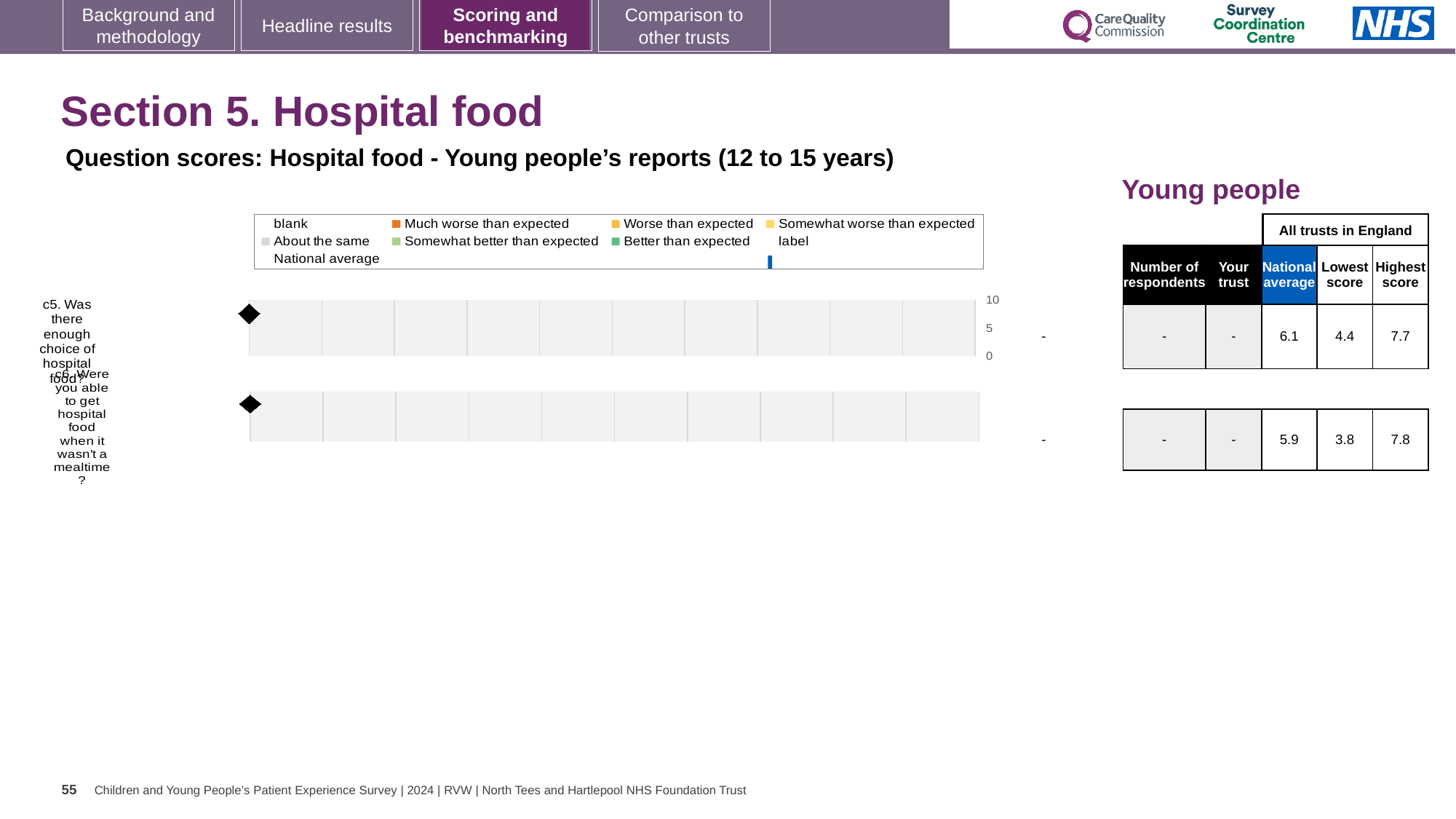
What kind of chart is shown on the slide? bar chart What is the difference between the highest score and the lowest score for c5 in the table? 3.3 In the table next to the chart, what is the lowest score across all trusts in England for c5? 4.4 What colour does the legend use for 'Much worse than expected'? orange In the table next to the chart, what is the national average score for c5 (Was there enough choice of hospital food?)? 6.1 What value is shown for 'Your trust' for c5 in the table? - What is the difference between the national averages of c5 and c6 in the table? 0.2 How many questions (categories) are plotted in the chart? 2 In the table next to the chart, what is the national average score for c6 (Were you able to get hospital food when it wasn't a mealtime?)? 5.9 In the table next to the chart, what is the highest score across all trusts in England for c6? 7.8 What is the highest tick value shown on the chart's axis? 10 Which question has the higher national average in the table, c5 or c6? c5